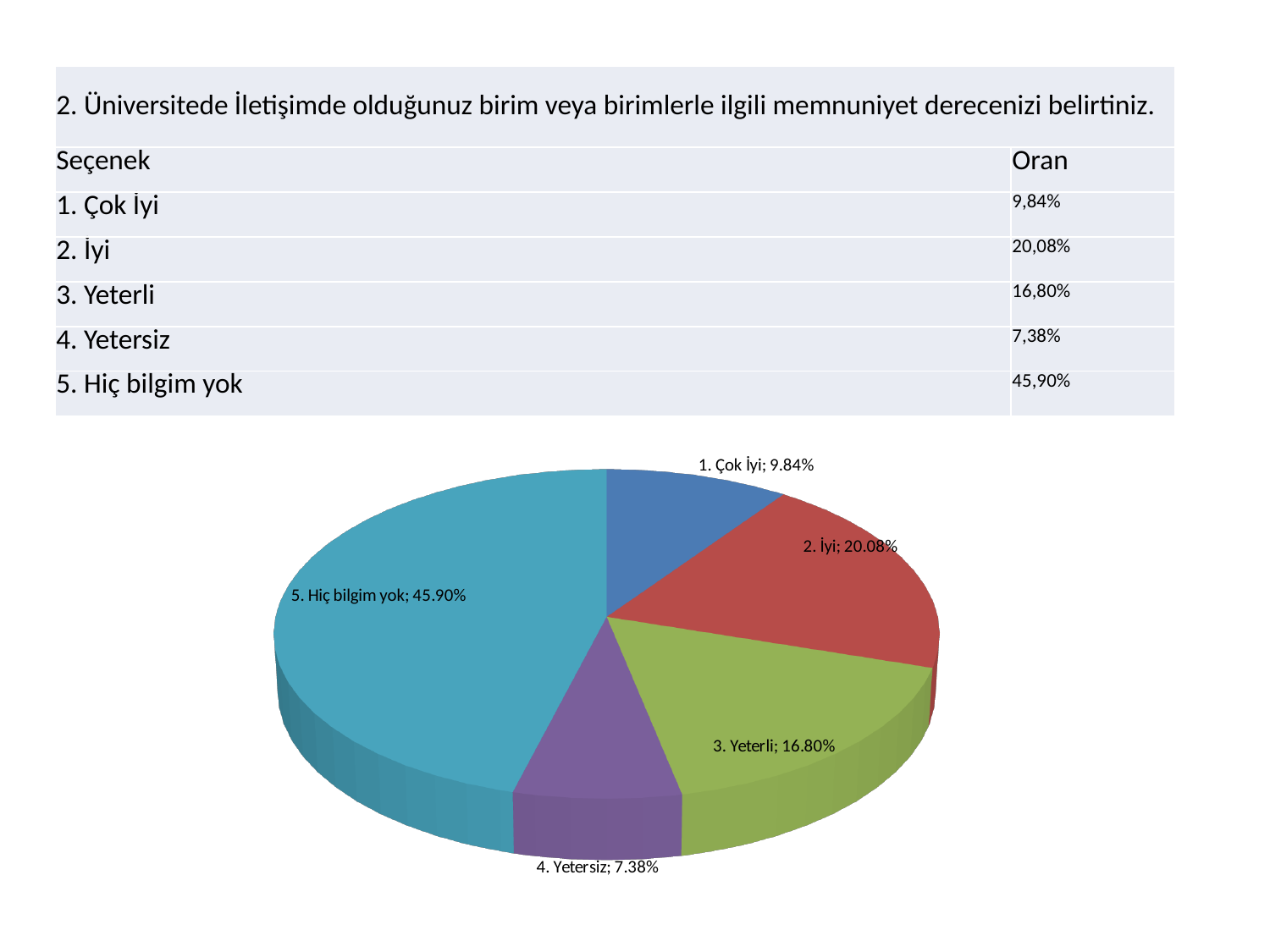
How many slices does the pie chart have? 5 Which slice of the pie chart is the largest? 5. Hiç bilgim yok What is the value shown for the slice "2. İyi"? 20.08% What is the value shown for the slice "3. Yeterli"? 16.80% What colour is the slice for "5. Hiç bilgim yok"? Teal (light blue) Which is larger, the slice for "2. İyi" or the slice for "3. Yeterli"? 2. İyi What is the value shown for the slice "5. Hiç bilgim yok"? 45.90% What is the value shown for the slice "1. Çok İyi"? 9.84% What is the difference between the values for "5. Hiç bilgim yok" and "2. İyi"? 25.82% Which slice of the pie chart is the smallest? 4. Yetersiz What kind of chart is shown on the slide? Pie chart What is the value shown for the slice "4. Yetersiz"? 7.38%